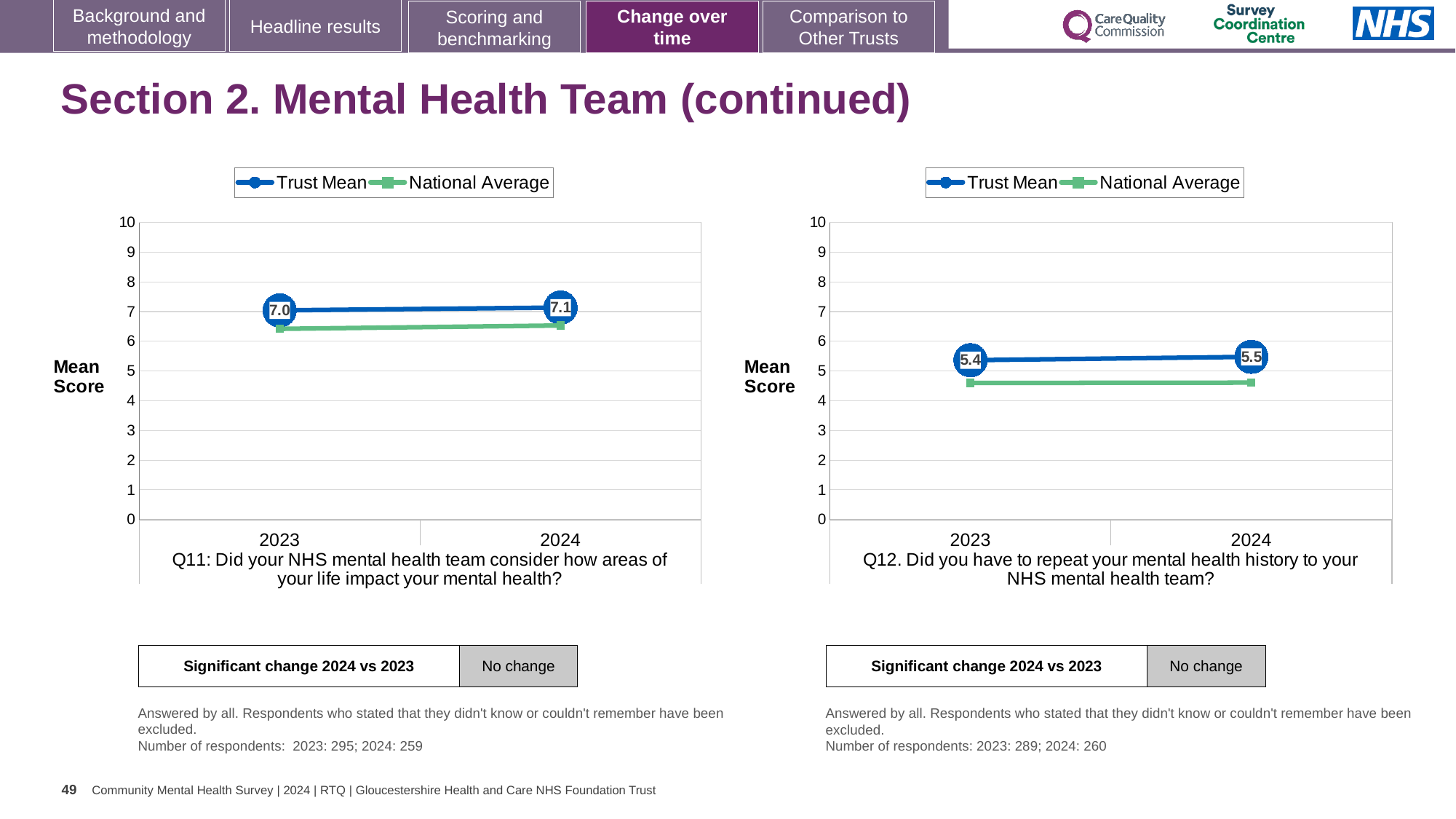
How many series does the legend of the Q11 chart (left) list? 2 In the Q12 chart (right), is the National Average for 2024 greater or less than 5? less How many years are plotted on the x axis of the Q12 chart (right)? 2 What kind of chart is the Q11 chart (left)? line chart In the Q12 chart (right), which is higher in 2023, the Trust Mean or the National Average? Trust Mean In the Q11 chart (left), by how much did the Trust Mean change from 2023 to 2024? 0.1 In the Q12 chart (right), what is the Trust Mean for 2024? 5.5 In the Q12 chart (right), what is the Trust Mean for 2023? 5.4 In the Q11 chart (left), what is the Trust Mean for 2023? 7.0 In the Q11 chart (left), is the National Average for 2023 greater or less than 6? greater In the Q12 chart (right), does the Trust Mean rise or fall from 2023 to 2024? rise In the Q11 chart (left), what is the Trust Mean for 2024? 7.1